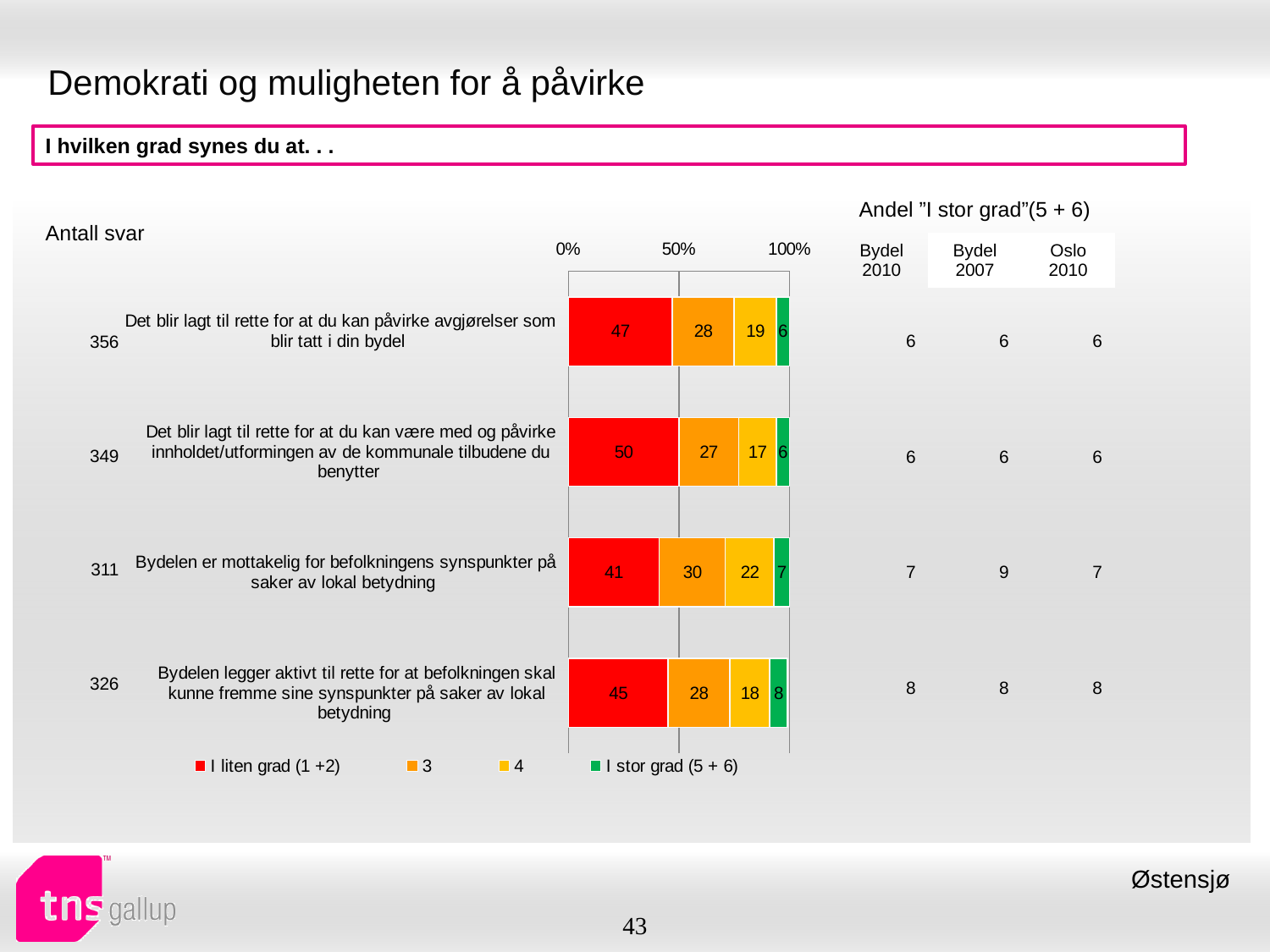
What is the label of the series shown in red in the legend? I liten grad (1 +2) What is the value of 'I stor grad (5 + 6)' for 'Bydelen legger aktivt til rette for at befolkningen skal kunne fremme sine synspunkter på saker av lokal betydning'? 8 Which is larger: the series '3' value for 'Bydelen er mottakelig for befolkningens synspunkter på saker av lokal betydning' or for 'Det blir lagt til rette for at du kan være med og påvirke innholdet/utformingen av de kommunale tilbudene du benytter'? Bydelen er mottakelig for befolkningens synspunkter på saker av lokal betydning What is the difference between the 'I liten grad (1 +2)' values for 'Det blir lagt til rette for at du kan være med og påvirke innholdet/utformingen av de kommunale tilbudene du benytter' and 'Bydelen er mottakelig for befolkningens synspunkter på saker av lokal betydning'? 9 What kind of chart is shown on the slide? stacked bar chart Which statement has the highest value for 'I liten grad (1 +2)'? Det blir lagt til rette for at du kan være med og påvirke innholdet/utformingen av de kommunale tilbudene du benytter How many statements (categories) are plotted in the chart? 4 Which statement has the lowest value for 'I liten grad (1 +2)'? Bydelen er mottakelig for befolkningens synspunkter på saker av lokal betydning What is the value of 'I liten grad (1 +2)' for 'Bydelen er mottakelig for befolkningens synspunkter på saker av lokal betydning'? 41 What is the total of the stacked bar for 'Det blir lagt til rette for at du kan påvirke avgjørelser som blir tatt i din bydel'? 100 How many series does the chart legend list? 4 What is the value of series '4' for 'Det blir lagt til rette for at du kan påvirke avgjørelser som blir tatt i din bydel'? 19